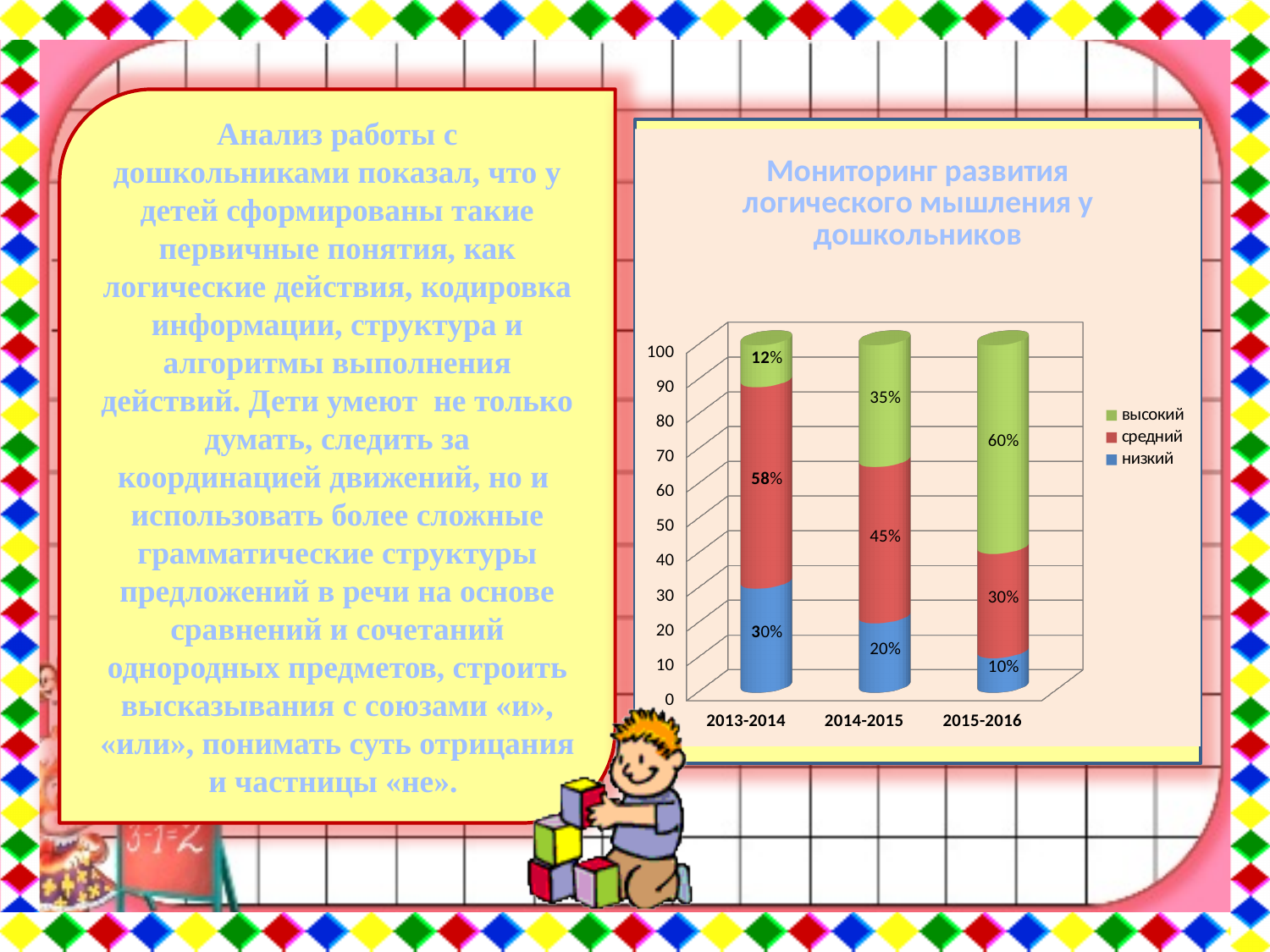
In which year is the низкий value the lowest? 2015-2016 Which is larger: средний in 2013-2014 or средний in 2015-2016? средний in 2013-2014 What is the value for высокий in 2015-2016? 60% How many year categories are shown on the x axis? 3 In which year is the высокий value the highest? 2015-2016 What is the value for высокий in 2013-2014? 12% What is the value for низкий in 2013-2014? 30% What is the difference between the высокий values for 2015-2016 and 2013-2014? 48% What is the value for средний in 2014-2015? 45% How many series does the legend list? 3 What kind of chart is shown? stacked bar chart Does the высокий value rise or fall from 2013-2014 to 2015-2016? rise